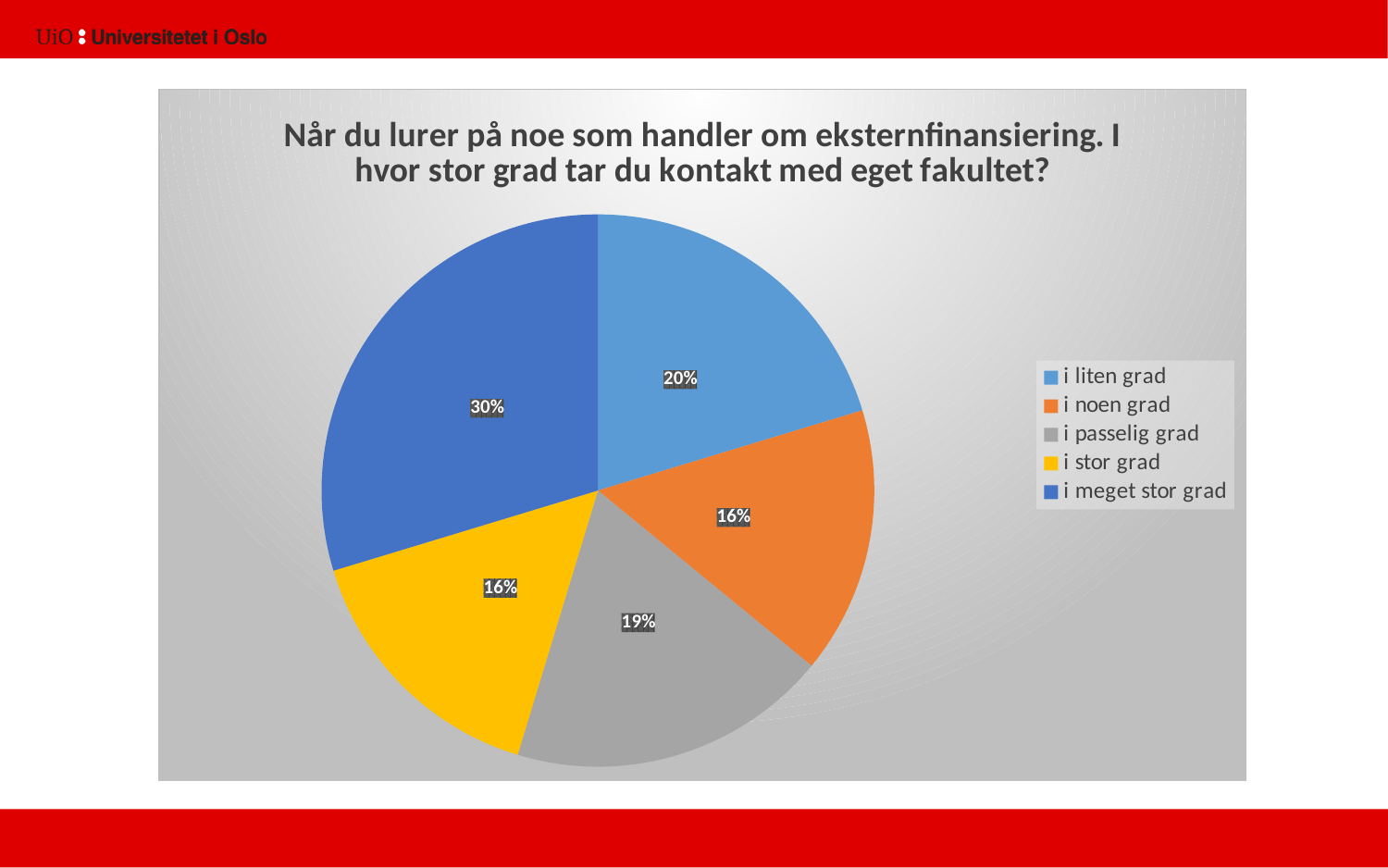
How many entries does the legend list? 5 What is the difference between the shares for 'i meget stor grad' and 'i liten grad'? 10% What share of the pie does 'i meget stor grad' have? 30% What is the value for 'i stor grad'? 16% Which is larger, the share for 'i liten grad' or the share for 'i noen grad'? i liten grad What colour is the slice for 'i stor grad'? yellow What is the value for 'i noen grad'? 16% Which category has the largest share of the pie? i meget stor grad What kind of chart is shown on the slide? pie chart What is the value for 'i passelig grad'? 19% How many slices does the pie chart have? 5 What is the value for 'i liten grad'? 20%